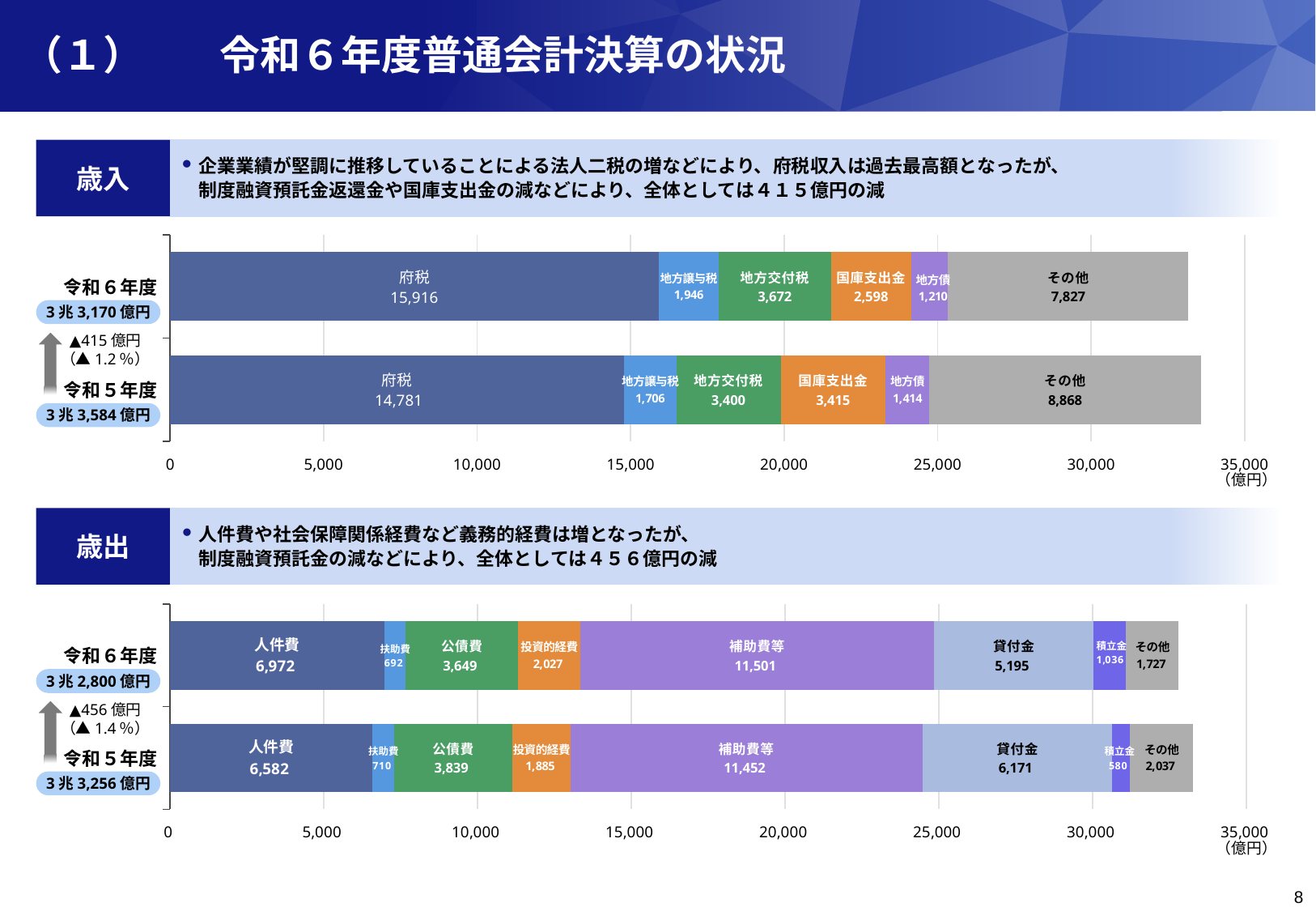
In the 歳出 (expenditure) chart, what is the value of 積立金 for 令和5年度? 580 What type of chart is used for the 歳入 (revenue) data? Stacked bar chart In the 歳入 (revenue) chart, what is the value of 国庫支出金 for 令和5年度? 3,415 In the 歳出 (expenditure) chart, how many segments make up each stacked bar? 8 In the 歳入 (revenue) chart, by how much did 府税 increase from 令和5年度 to 令和6年度? 1,135 In the 歳出 (expenditure) chart, what is the difference between 貸付金 in 令和5年度 and 令和6年度? 976 In the 歳入 (revenue) chart, which segment of the 令和5年度 bar is the smallest? 地方債 In the 歳入 (revenue) chart, what is the value of 府税 for 令和6年度? 15,916 In the 歳入 (revenue) chart, which segment of the 令和6年度 bar is the largest? 府税 In the 歳出 (expenditure) chart, which is larger: 貸付金 in 令和6年度 or 貸付金 in 令和5年度? 令和5年度 In the 歳出 (expenditure) chart, what is the value of 補助費等 for 令和6年度? 11,501 In the 歳入 (revenue) chart, what is the total shown for the 令和6年度 bar? 3兆3,170億円